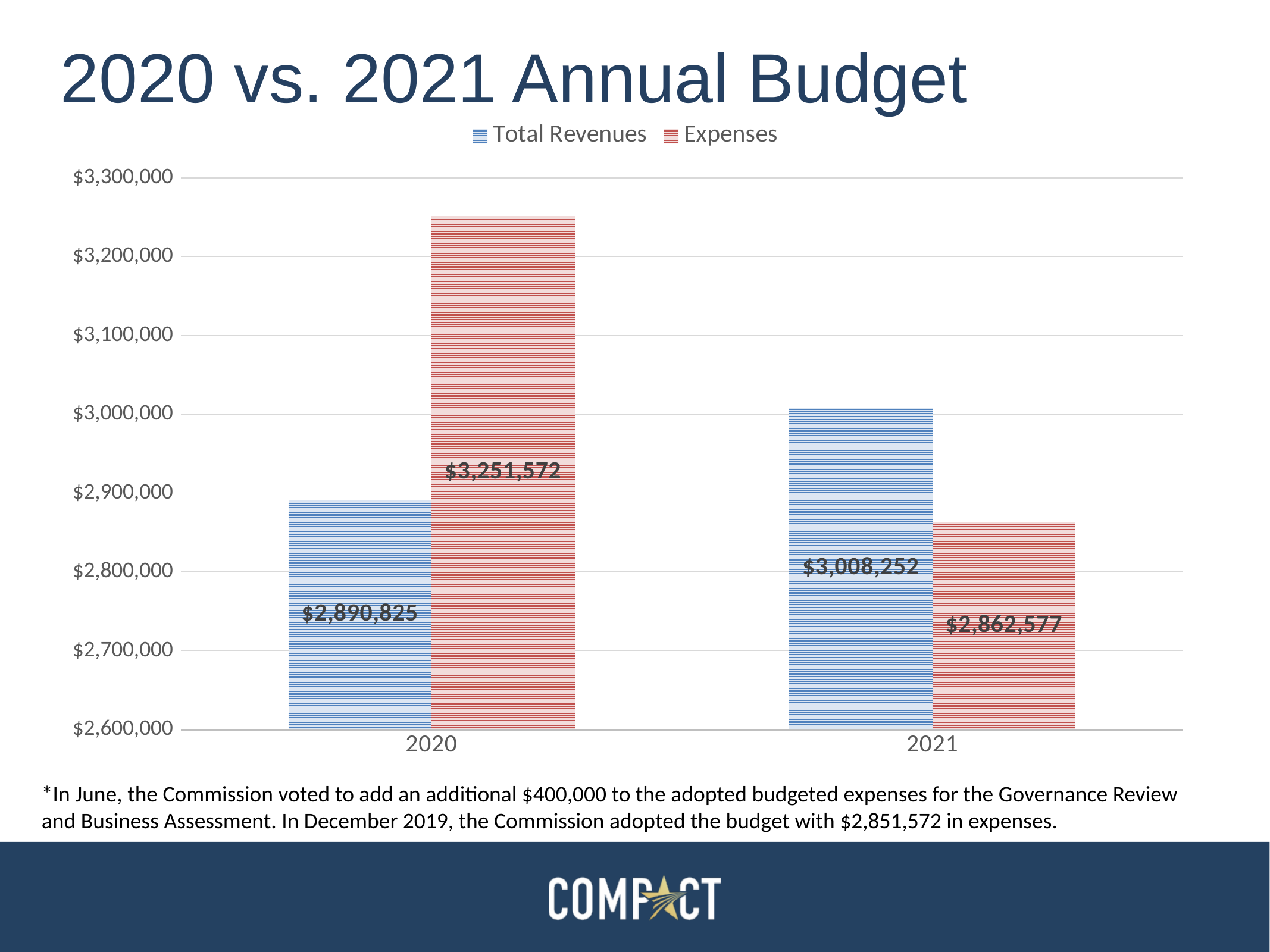
What is the difference between Total Revenues and Expenses in 2021? $145,675 Is the Expenses value for 2020 greater or less than $3,200,000? greater What kind of chart is shown on the slide? Bar chart What is the value of Total Revenues for 2021? $3,008,252 In 2021, which is larger: Total Revenues or Expenses? Total Revenues Which year has the lower Total Revenues value? 2020 What is the value of Expenses for 2020? $3,251,572 What is the value of Expenses for 2021? $2,862,577 How many series does the legend list? 2 What is the difference between Expenses and Total Revenues in 2020? $360,747 What is the value of Total Revenues for 2020? $2,890,825 Which year has the higher Expenses value? 2020